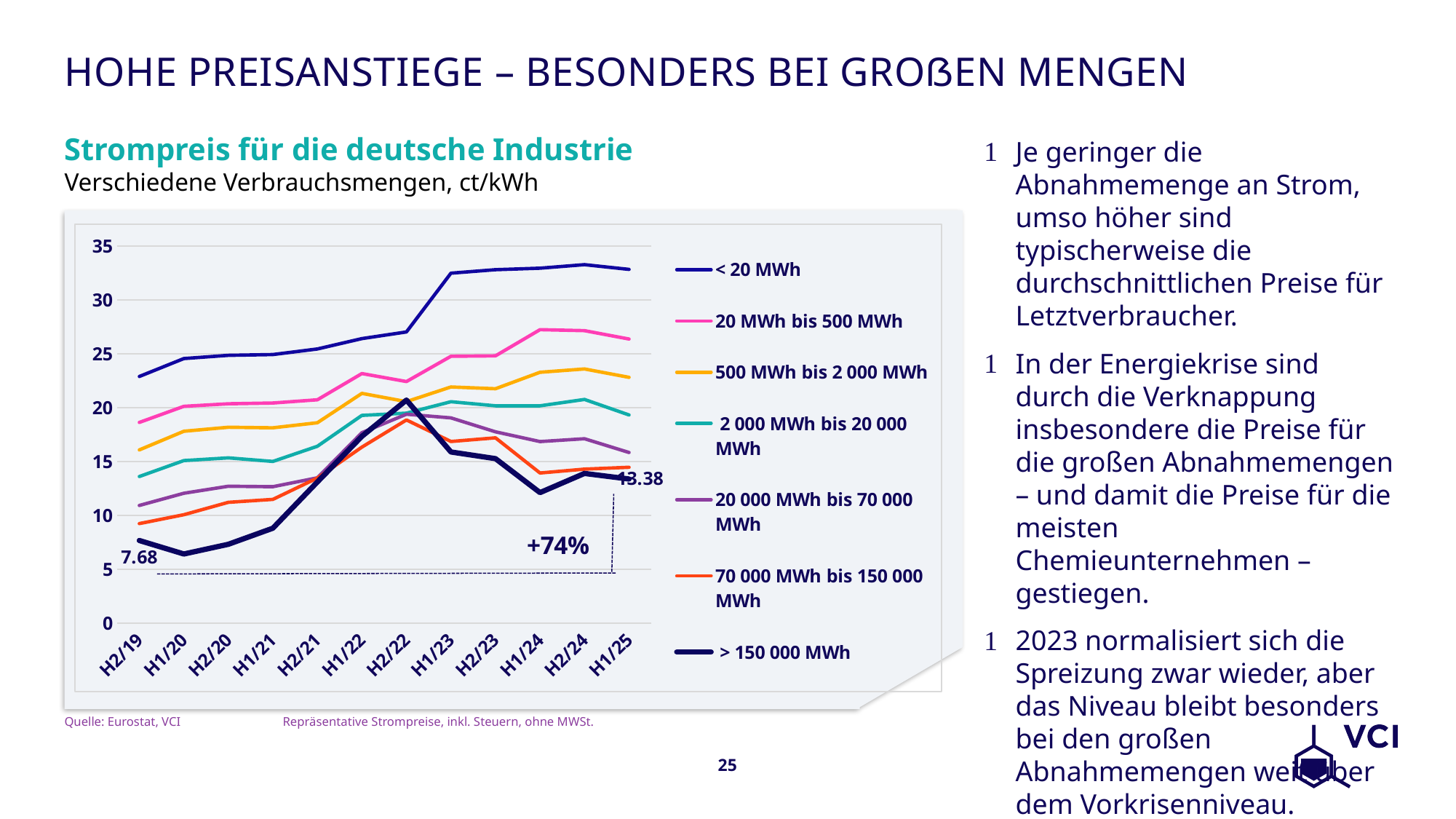
Is the value for < 20 MWh in H1/25 greater or less than 30? greater What kind of chart is shown on the slide? line chart How many series does the chart legend list? 7 Which is larger in H1/24: the value for < 20 MWh or the value for 20 MWh bis 500 MWh? < 20 MWh How many time periods are shown on the x axis of the chart? 12 What percentage change is annotated on the chart for the > 150 000 MWh series? +74% What is the value for > 150 000 MWh in H2/19? 7.68 What is the value for > 150 000 MWh in H1/25? 13.38 Is the value for 20 MWh bis 500 MWh in H2/19 greater or less than 20? less By how much did the value for > 150 000 MWh increase from H2/19 to H1/25? 5.70 Which series has the highest value in H1/25? < 20 MWh Which series has the lowest value in H2/19? > 150 000 MWh